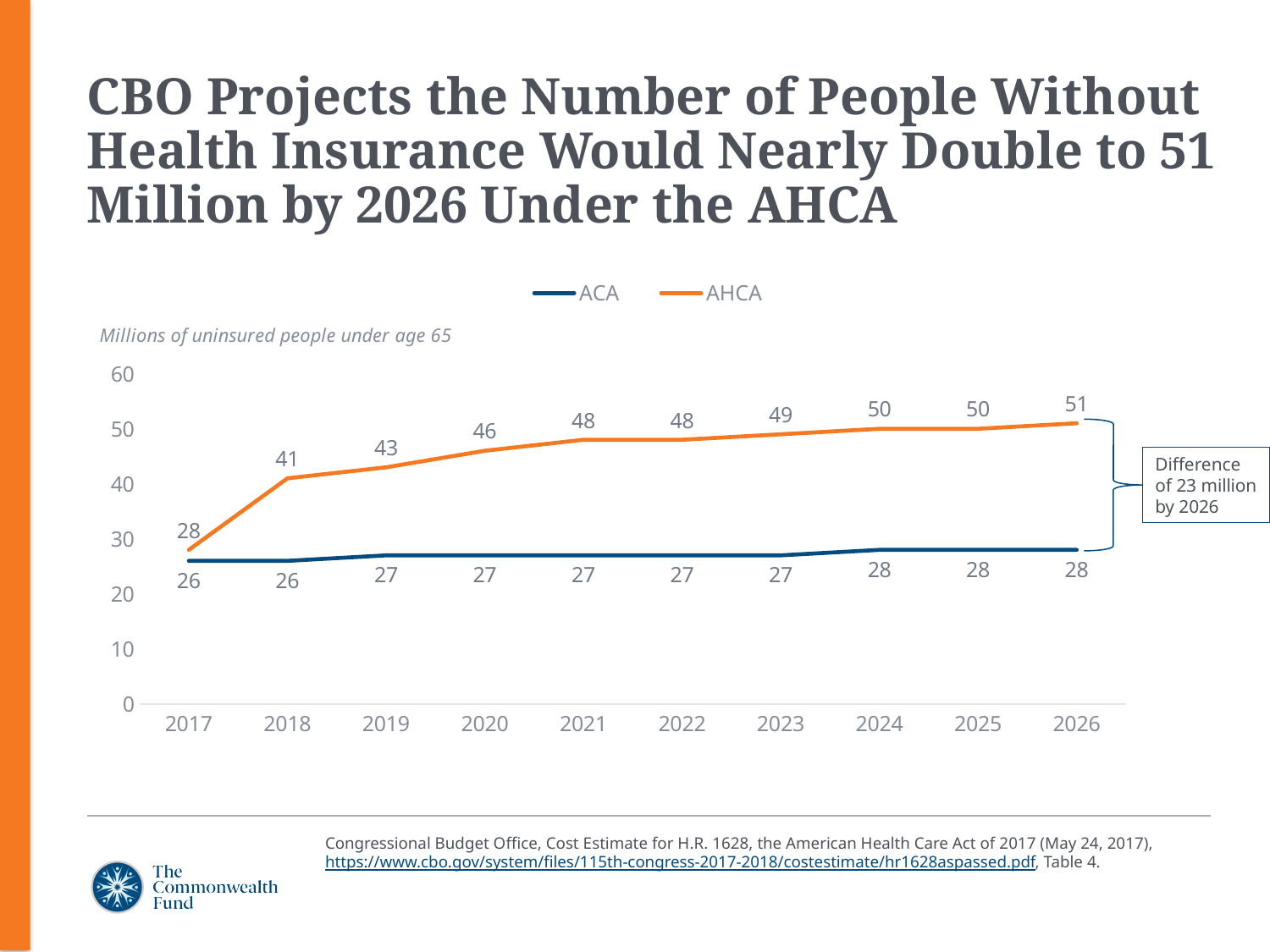
What is the AHCA value for 2018? 41 In which year is the AHCA series highest? 2026 In which year is the AHCA series lowest? 2017 What kind of chart is shown on the slide? Line chart How many series does the legend list? 2 What is the AHCA value for 2026? 51 Does the AHCA series rise or fall from 2017 to 2026? Rise What is the difference between the AHCA values for 2018 and 2017? 13 Which series has the larger value in 2020, ACA or AHCA? AHCA What is the difference between the AHCA and ACA values in 2026? 23 How many years are shown on the x axis? 10 What is the ACA value for 2017? 26